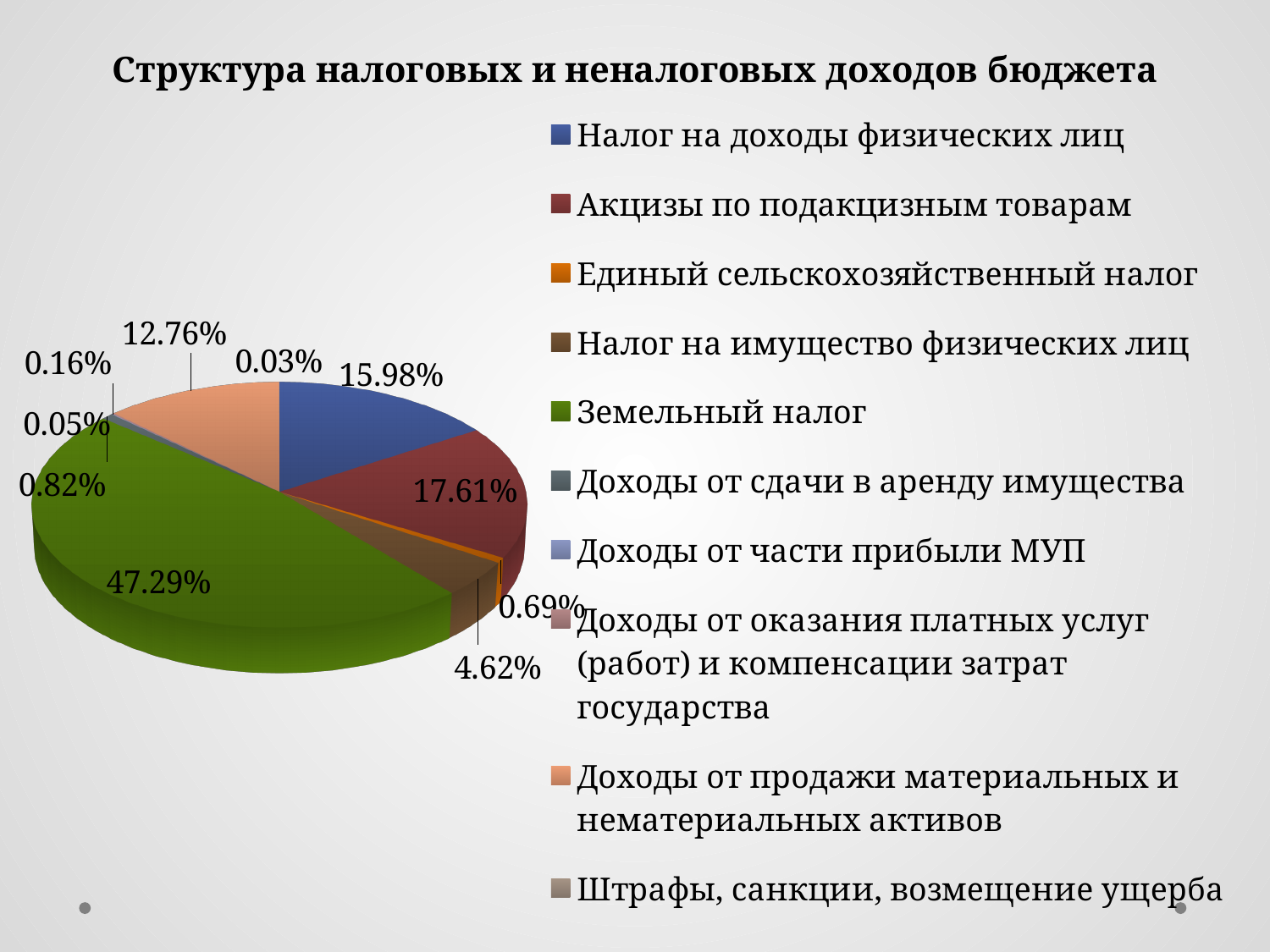
What share of the pie is Земельный налог? 47.29% Which is larger: Акцизы по подакцизным товарам or Налог на доходы физических лиц? Акцизы по подакцизным товарам What is the difference between the shares of Земельный налог and Акцизы по подакцизным товарам? 29.68% What share of the pie is Доходы от продажи материальных и нематериальных активов? 12.76% What share of the pie is Налог на доходы физических лиц? 15.98% What colour is the slice for Земельный налог? green How many entries does the chart legend list? 10 What is the title of the chart? Структура налоговых и неналоговых доходов бюджета Which category has the largest share of the pie? Земельный налог What kind of chart is shown on the slide? pie chart